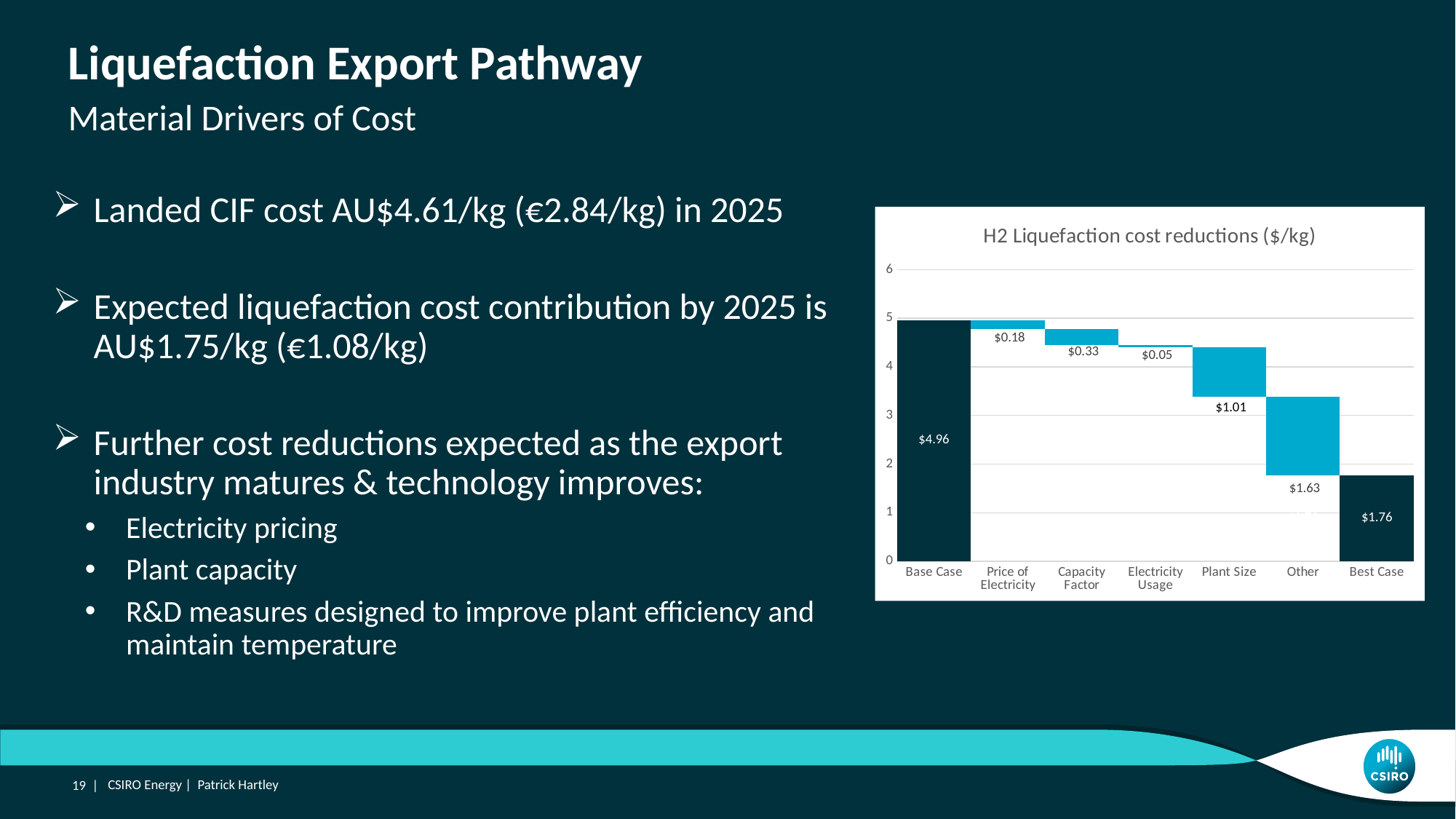
Which is larger, the Plant Size reduction or the Capacity Factor reduction? Plant Size What is the value labelled on the Other bar? $1.63 How many categories are shown on the x axis of the chart? 7 Which cost reduction step (excluding Base Case and Best Case) has the largest value? Other What kind of chart is shown on the slide? bar chart What is the title of the chart? H2 Liquefaction cost reductions ($/kg) What is the value labelled on the Electricity Usage bar? $0.05 Which cost reduction step has the smallest value? Electricity Usage What is the value shown for the Base Case bar in the H2 Liquefaction cost reductions chart? $4.96 What is the difference between the Base Case value and the Best Case value? $3.20 What is the value shown for the Best Case bar? $1.76 What is the value labelled on the Plant Size bar? $1.01